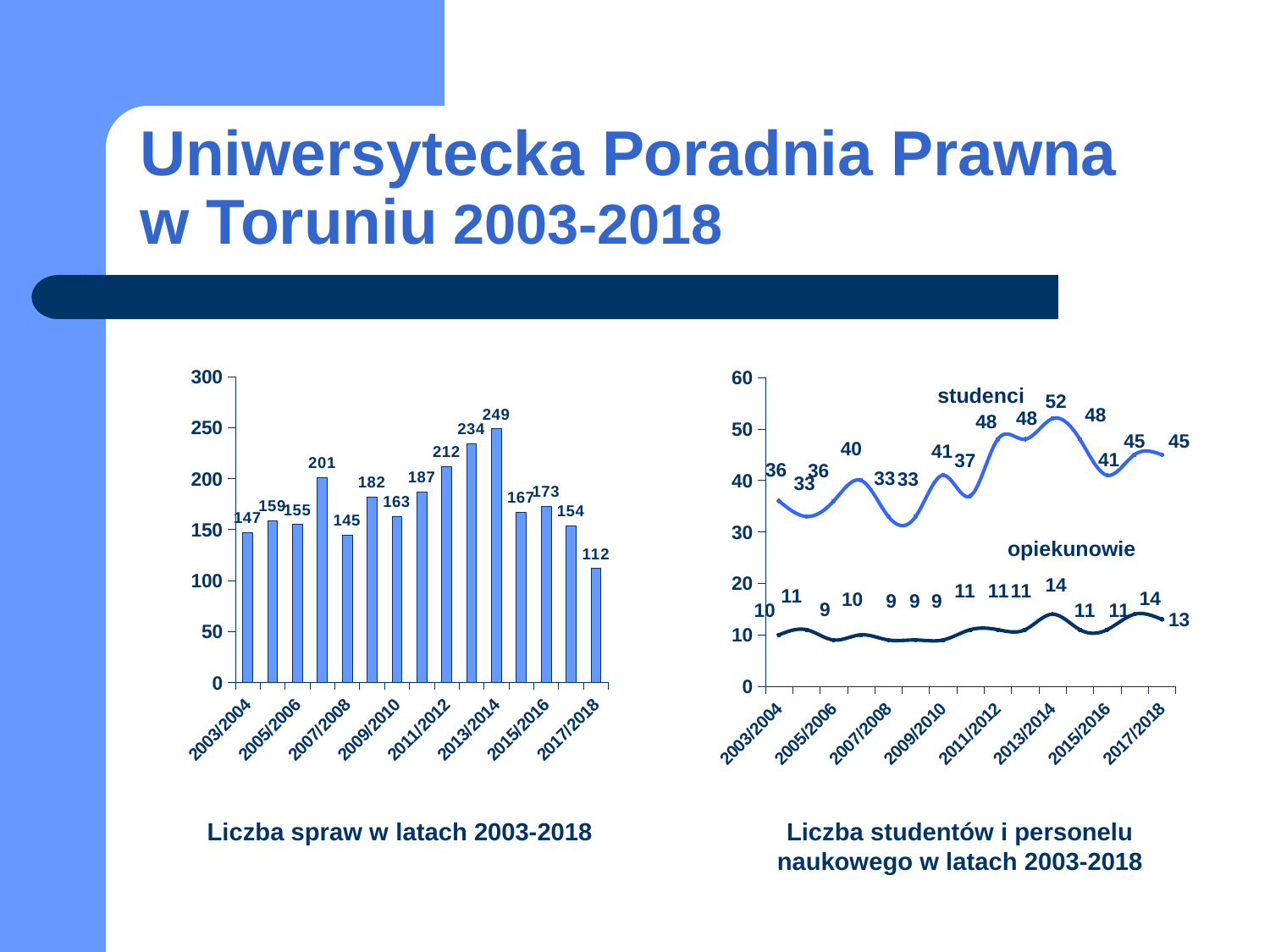
In the chart 'Liczba spraw w latach 2003-2018', which is larger: the value for 2011/2012 or the value for 2009/2010? 2011/2012 In the chart 'Liczba studentów i personelu naukowego w latach 2003-2018', what is the highest value for studenci? 52 In the chart 'Liczba studentów i personelu naukowego w latach 2003-2018', what is the value for opiekunowie in 2017/2018? 13 In the chart 'Liczba spraw w latach 2003-2018', which year has the lowest number of cases? 2017/2018 In the chart 'Liczba studentów i personelu naukowego w latach 2003-2018', what is the value for studenci in 2017/2018? 45 What kind of chart is 'Liczba spraw w latach 2003-2018'? bar chart In the chart 'Liczba studentów i personelu naukowego w latach 2003-2018', what is the difference between studenci (45) and opiekunowie (13) in 2017/2018? 32 How many series are plotted in the chart 'Liczba studentów i personelu naukowego w latach 2003-2018'? 2 In the chart 'Liczba spraw w latach 2003-2018', what is the value for 2013/2014? 249 In the chart 'Liczba spraw w latach 2003-2018', how many bars are plotted? 15 In the chart 'Liczba spraw w latach 2003-2018', what is the difference between the highest value (249) and the lowest value (112)? 137 In the chart 'Liczba spraw w latach 2003-2018', which year has the highest number of cases? 2013/2014